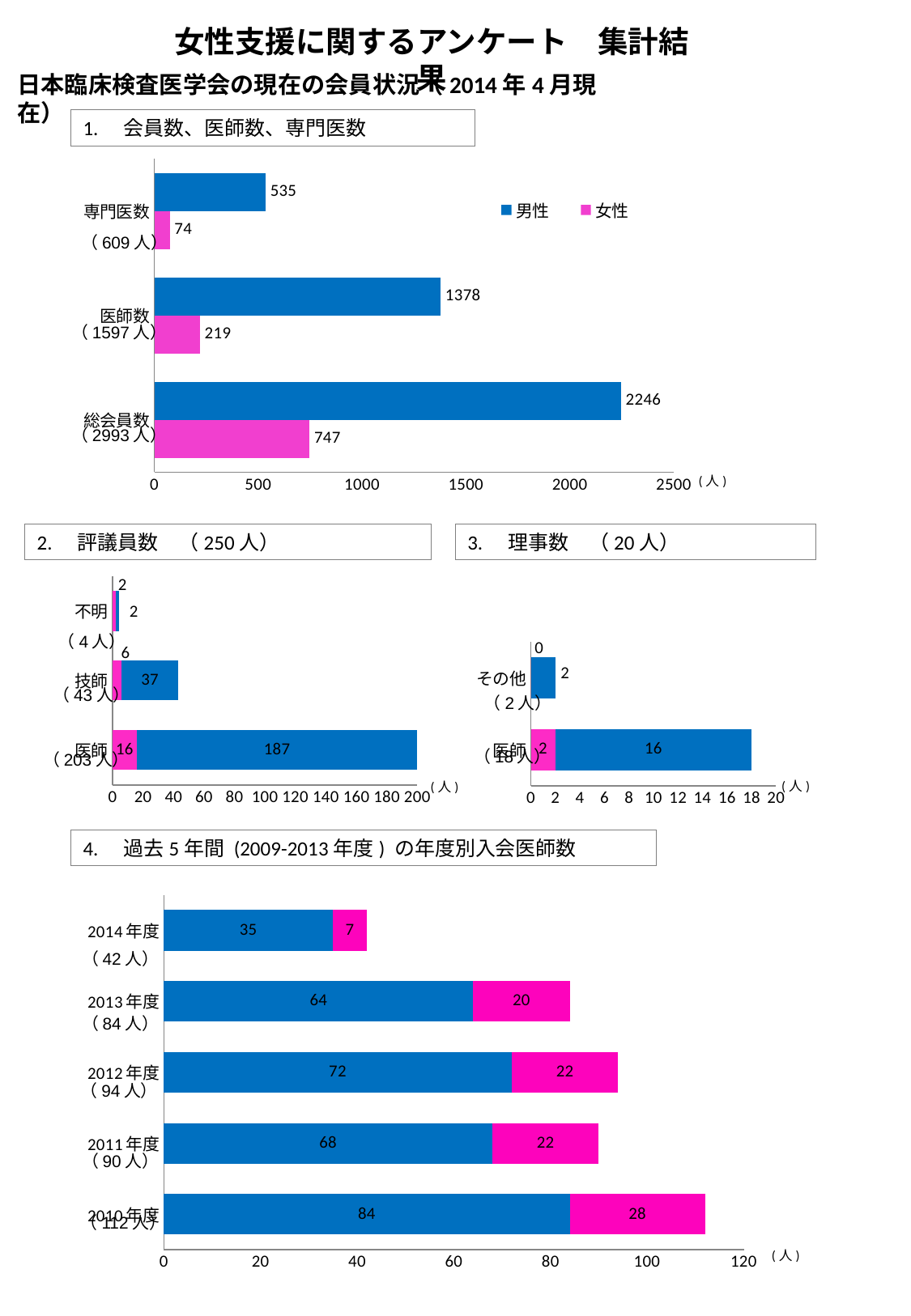
In the chart "4. 過去5年間の年度別入会医師数", how many year categories are shown? 5 In the chart "1. 会員数、医師数、専門医数", what is the value for 女性 in the 専門医数 category? 74 What kind of chart is "1. 会員数、医師数、専門医数"? Bar chart In the chart "2. 評議員数 (250人)", what is the total of the stacked bar for 技師? 43 In the chart "1. 会員数、医師数、専門医数", what is the difference between the 男性 and 女性 values for 医師数? 1159 In the chart "1. 会員数、医師数、専門医数", how many series does the legend list? 2 In the chart "1. 会員数、医師数、専門医数", what is the value for 男性 in the 総会員数 category? 2246 In the chart "3. 理事数 (20人)", what is the blue (男性) value for 医師? 16 In the chart "3. 理事数 (20人)", what is the pink (女性) value for その他? 0 In the chart "2. 評議員数 (250人)", what is the blue (男性) value for 医師? 187 In the chart "4. 過去5年間の年度別入会医師数", what is the pink (女性) value for 2013年度? 20 In the chart "4. 過去5年間の年度別入会医師数", which year has the highest total number of new physicians? 2010年度